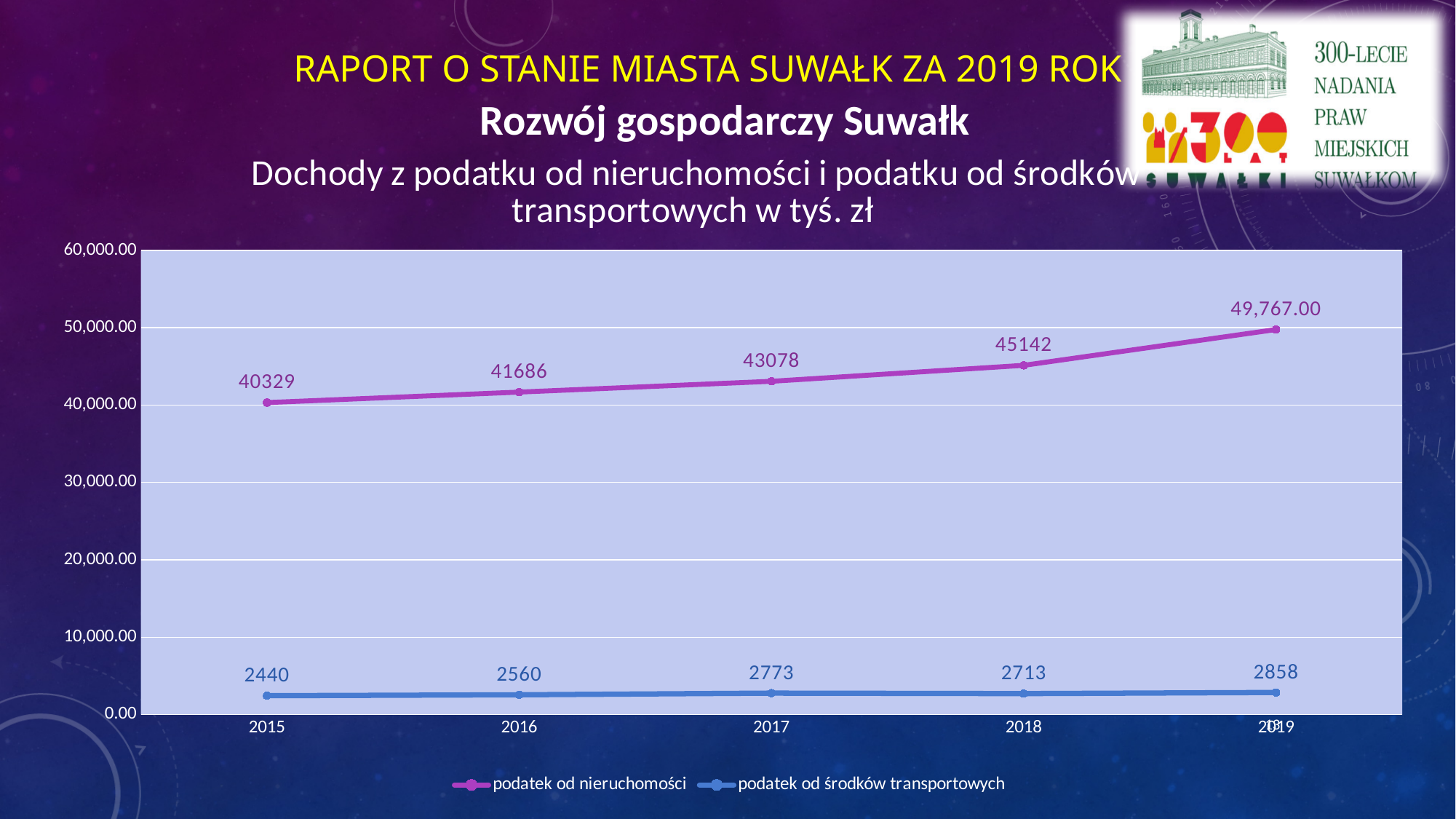
What is the value of 'podatek od nieruchomości' in 2019? 49,767.00 Which is larger: 'podatek od środków transportowych' in 2017 or in 2018? 2017 How many years are shown on the x axis? 5 What is the value of 'podatek od środków transportowych' in 2018? 2713 What is the value of 'podatek od środków transportowych' in 2017? 2773 In which year is 'podatek od środków transportowych' lowest? 2015 What is the value of 'podatek od nieruchomości' in 2015? 40329 Does 'podatek od nieruchomości' rise or fall from 2015 to 2019? rise What is the difference between 'podatek od nieruchomości' in 2018 and in 2017? 2064 What type of chart is shown on the slide? line chart In which year is 'podatek od nieruchomości' highest? 2019 How many series does the legend list? 2